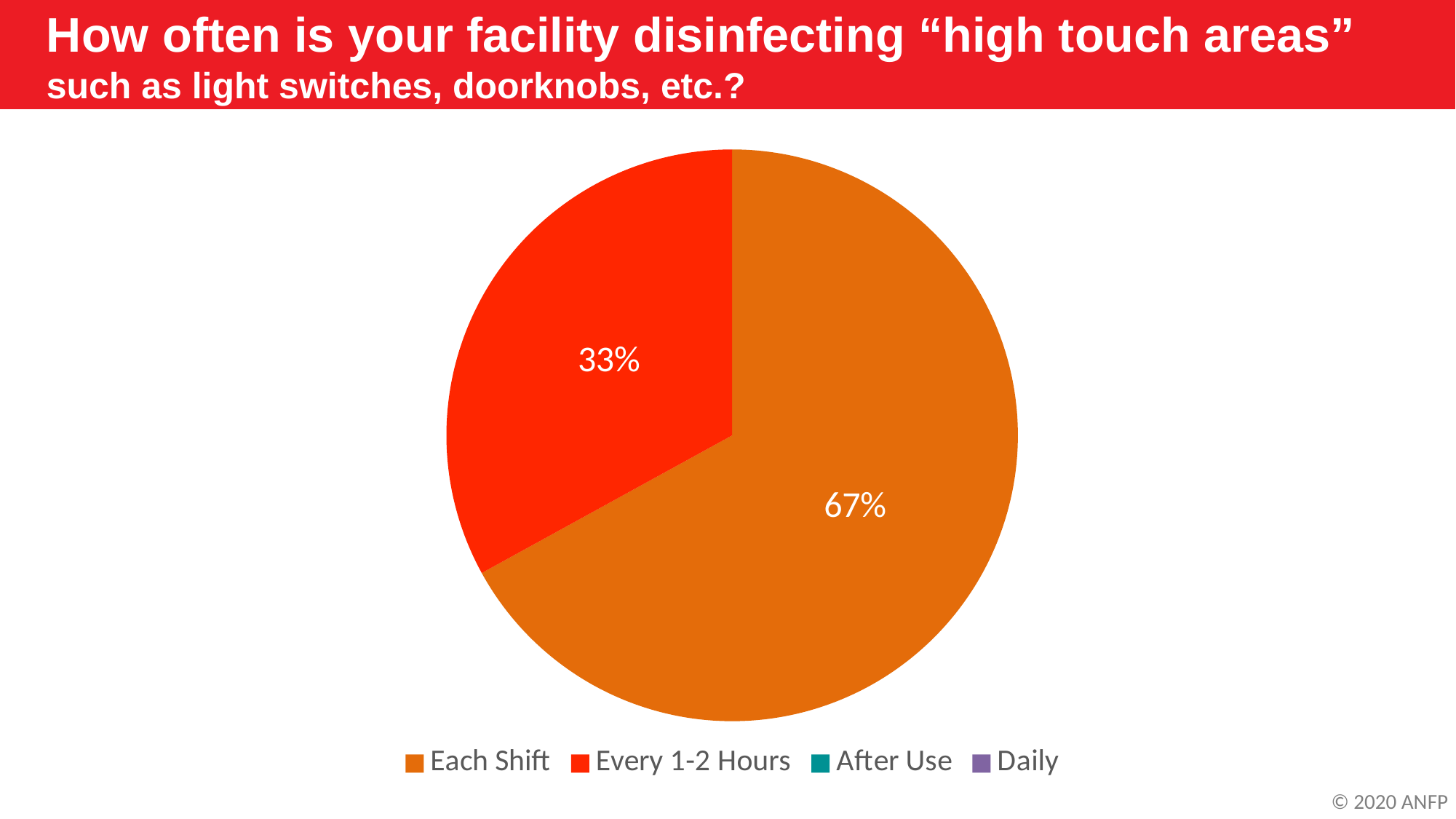
How many entries does the legend list? 4 Which legend entry is shown in red? Every 1-2 Hours Which category has the largest slice of the pie? Each Shift Is the share for Every 1-2 Hours greater or less than 50%? less How many slices with printed percentage labels are visible in the pie? 2 What share of the pie is labelled for Every 1-2 Hours? 33% Which legend entry is shown in orange? Each Shift Which of the two labelled slices is larger, Each Shift or Every 1-2 Hours? Each Shift What share of the pie is labelled for Each Shift? 67% What is the difference in percentage points between the Each Shift slice and the Every 1-2 Hours slice? 34 What kind of chart is shown on the slide? Pie chart